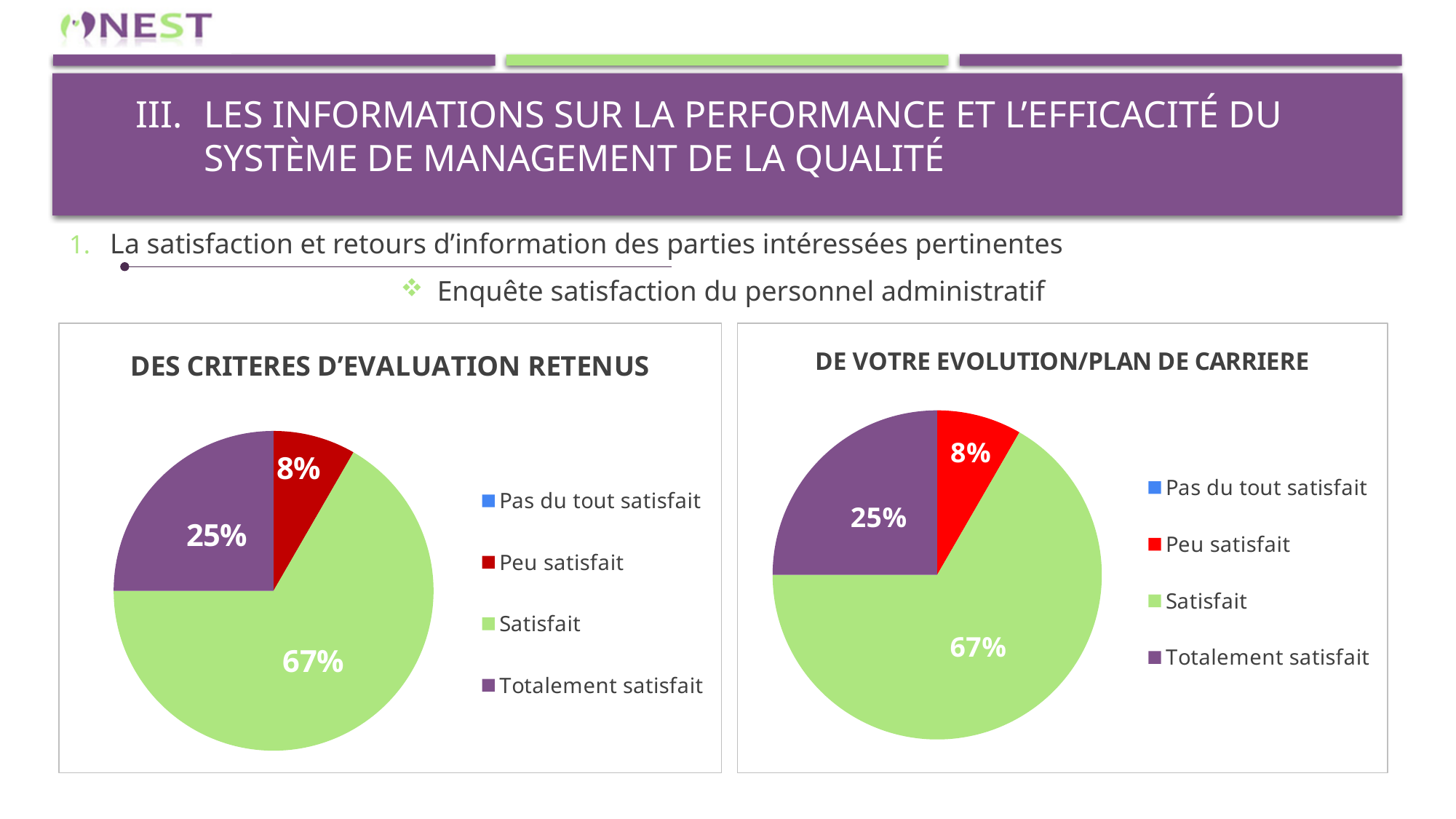
In the chart titled 'DE VOTRE EVOLUTION/PLAN DE CARRIERE', what share of the pie is 'Totalement satisfait'? 25% How many entries does the legend of the chart titled 'DES CRITERES D'EVALUATION RETENUS' list? 4 In the chart titled 'DE VOTRE EVOLUTION/PLAN DE CARRIERE', what percentage is shown for 'Peu satisfait'? 8% In the chart titled 'DES CRITERES D'EVALUATION RETENUS', what share of the pie is 'Satisfait'? 67% In the chart titled 'DE VOTRE EVOLUTION/PLAN DE CARRIERE', which is larger, 'Totalement satisfait' or 'Peu satisfait'? Totalement satisfait In the chart titled 'DE VOTRE EVOLUTION/PLAN DE CARRIERE', which category has the largest slice? Satisfait In the chart titled 'DE VOTRE EVOLUTION/PLAN DE CARRIERE', what colour is the 'Satisfait' slice? Green In the chart titled 'DES CRITERES D'EVALUATION RETENUS', what percentage is shown for 'Peu satisfait'? 8% In the chart titled 'DES CRITERES D'EVALUATION RETENUS', which labelled category has the smallest slice? Peu satisfait What type of chart is the chart titled 'DE VOTRE EVOLUTION/PLAN DE CARRIERE'? Pie chart In the chart titled 'DES CRITERES D'EVALUATION RETENUS', what percentage is shown for 'Totalement satisfait'? 25% In the chart titled 'DES CRITERES D'EVALUATION RETENUS', what is the difference in percentage points between 'Satisfait' and 'Totalement satisfait'? 42